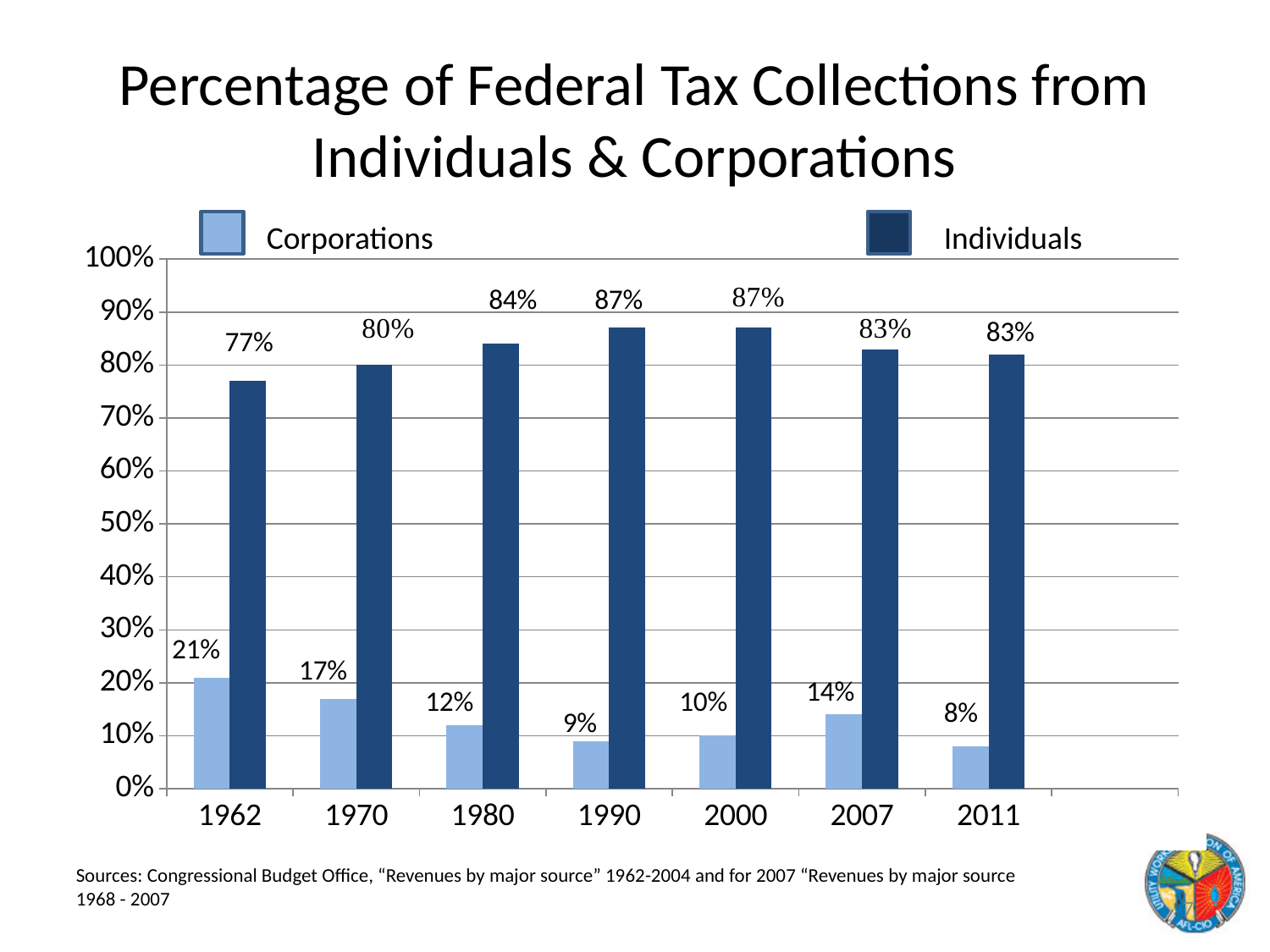
What percentage of federal tax collections came from Corporations in 1962? 21% In which year is the Corporations share lowest? 2011 What percentage of federal tax collections came from Individuals in 1990? 87% In which year is the Corporations share highest? 1962 Does the Corporations share generally rise or fall from 1962 to 2011? fall How many series does the legend list? 2 What is the difference between the Individuals and Corporations shares in 2007? 69% Which is larger, the Corporations share in 1970 or in 2007? 1970 How many years are shown on the x axis? 7 What kind of chart is shown on the slide? bar chart What is the value for Corporations in 2011? 8% Is the value for Individuals in 1962 greater or less than 80%? less